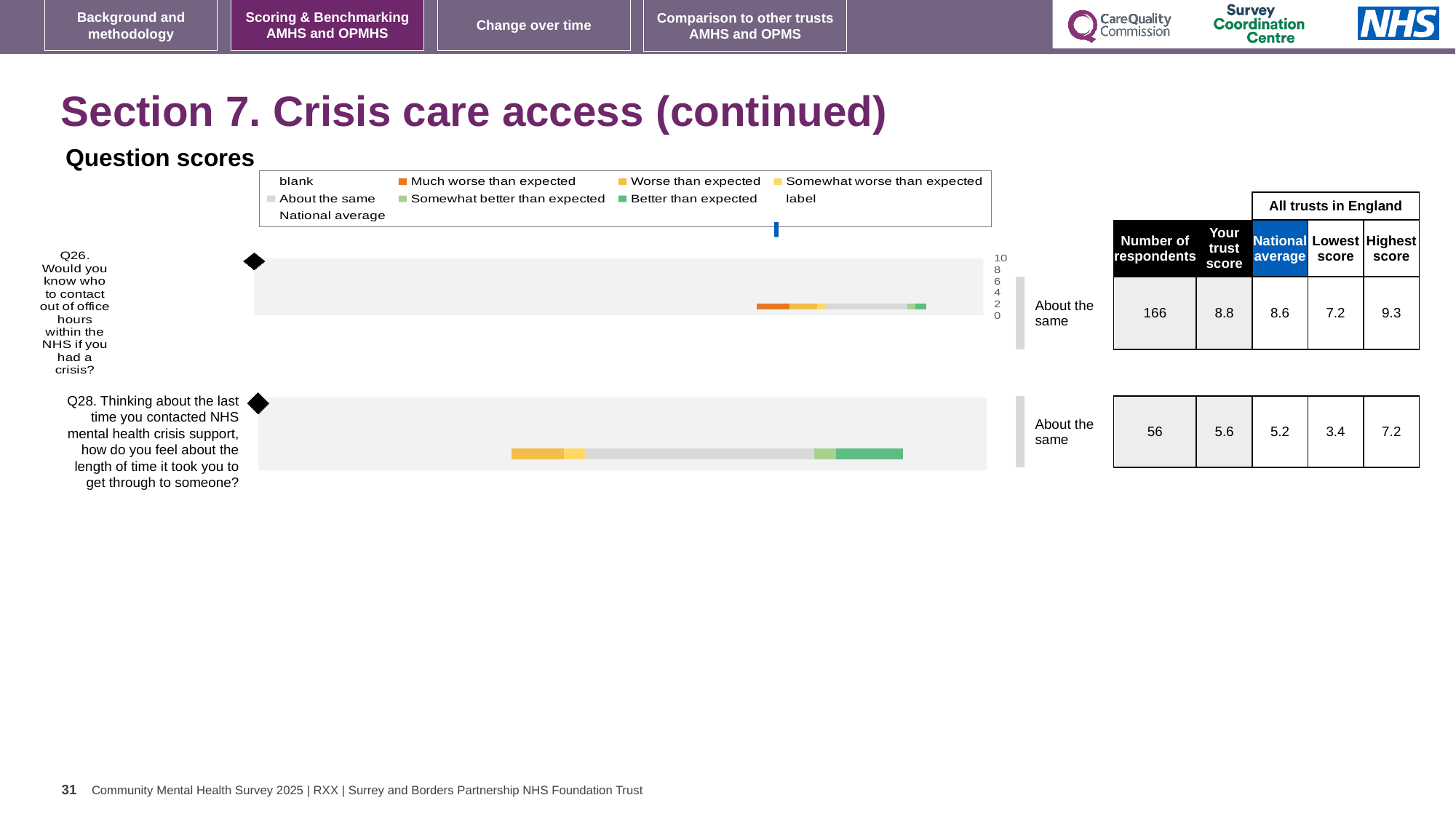
What colour does the legend use for 'Much worse than expected'? orange What is the difference between the highest and lowest scores for Q26? 2.1 How many questions are plotted in the question scores chart? 2 What is the highest score among all trusts in England for Q28? 7.2 What type of chart is used to show the question scores on this slide? bar chart How many respondents answered Q26? 166 By how much does the trust score for Q28 exceed the national average for Q28? 0.4 What is the trust score for Q26 (Would you know who to contact out of office hours within the NHS if you had a crisis?)? 8.8 How many respondents answered Q28? 56 What is the national average score for Q26? 8.6 Which question has the higher trust score, Q26 or Q28? Q26 What benchmark category is shown next to the Q26 bar? About the same